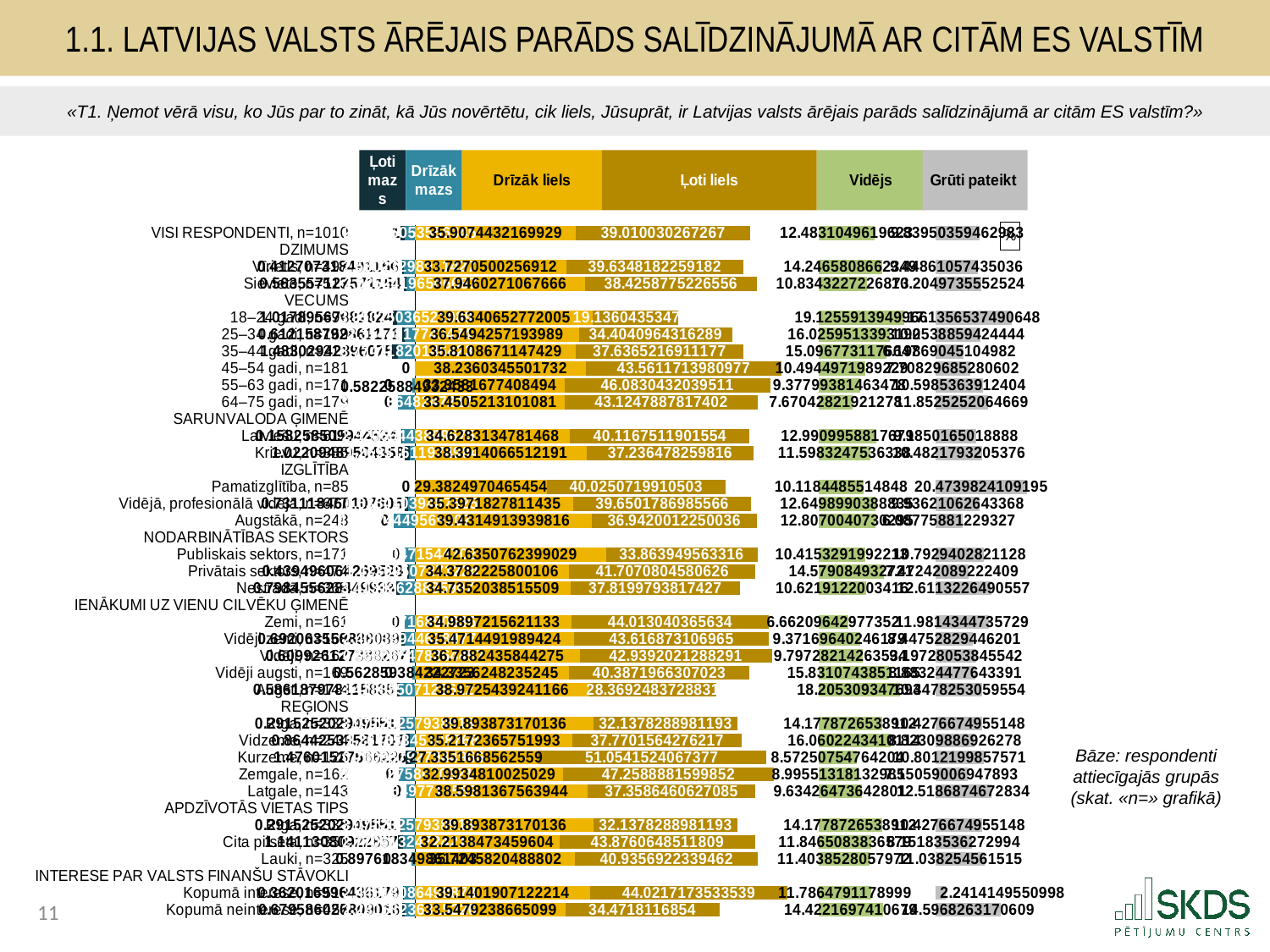
What is the difference between the "Ļoti liels" and "Drīzāk liels" values for "VISI RESPONDENTI, n=1010"? 3.1025870502741 Which legend entry is shown in grey? Grūti pateikt What is the value of the "Drīzāk liels" series for "VISI RESPONDENTI, n=1010"? 35.9074432169929 Among the age groups (VECUMS), which has the lowest "Ļoti liels" value? 18–24 gadi What kind of chart is shown on the slide? bar chart How many series does the legend list? 6 What is the value of the "Ļoti liels" series for "Zemgale"? 47.2588881599852 Which is larger, the "Ļoti liels" value for "Kurzeme" or for "Latgale, n=143"? Kurzeme What is the value of the "Ļoti liels" series for "Kurzeme"? 51.0541524067377 Among the regions (REĢIONS), which has the highest "Ļoti liels" value? Kurzeme What is the value of the "Ļoti liels" series for "Pamatizglītība, n=85"? 40.0250719910503 What is the value of the "Ļoti liels" series for "VISI RESPONDENTI, n=1010"? 39.010030267267